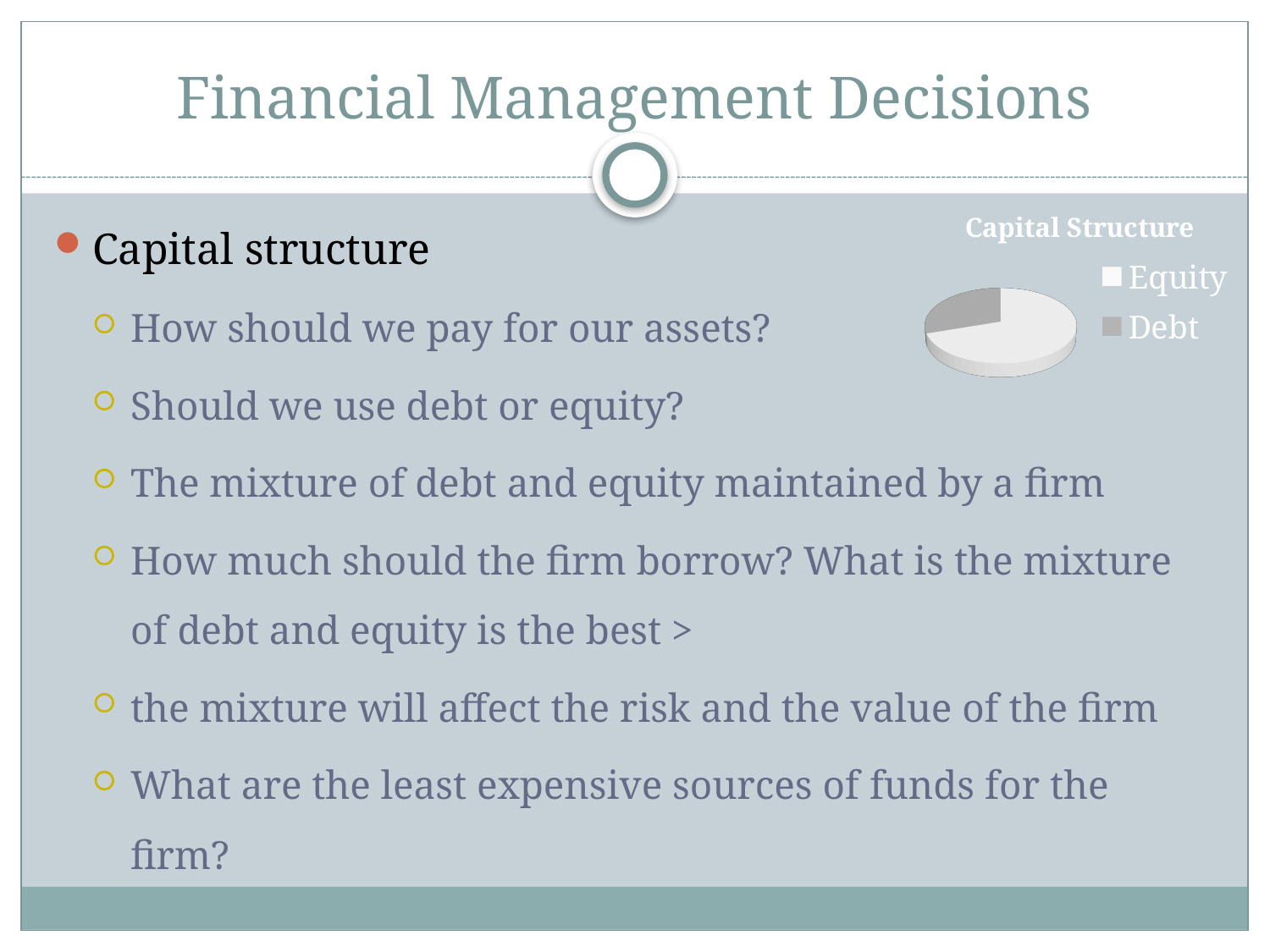
What is the title of the chart on the slide? Capital Structure What kind of chart is shown on the slide? pie chart Which legend entry in the Capital Structure chart is shown in gray? Debt Which slice of the Capital Structure pie chart is the smallest? Debt Which slice of the Capital Structure pie chart is the largest? Equity In the Capital Structure pie chart, which is larger, Equity or Debt? Equity How many entries does the legend of the Capital Structure chart list? 2 How many slices does the Capital Structure pie chart have? 2